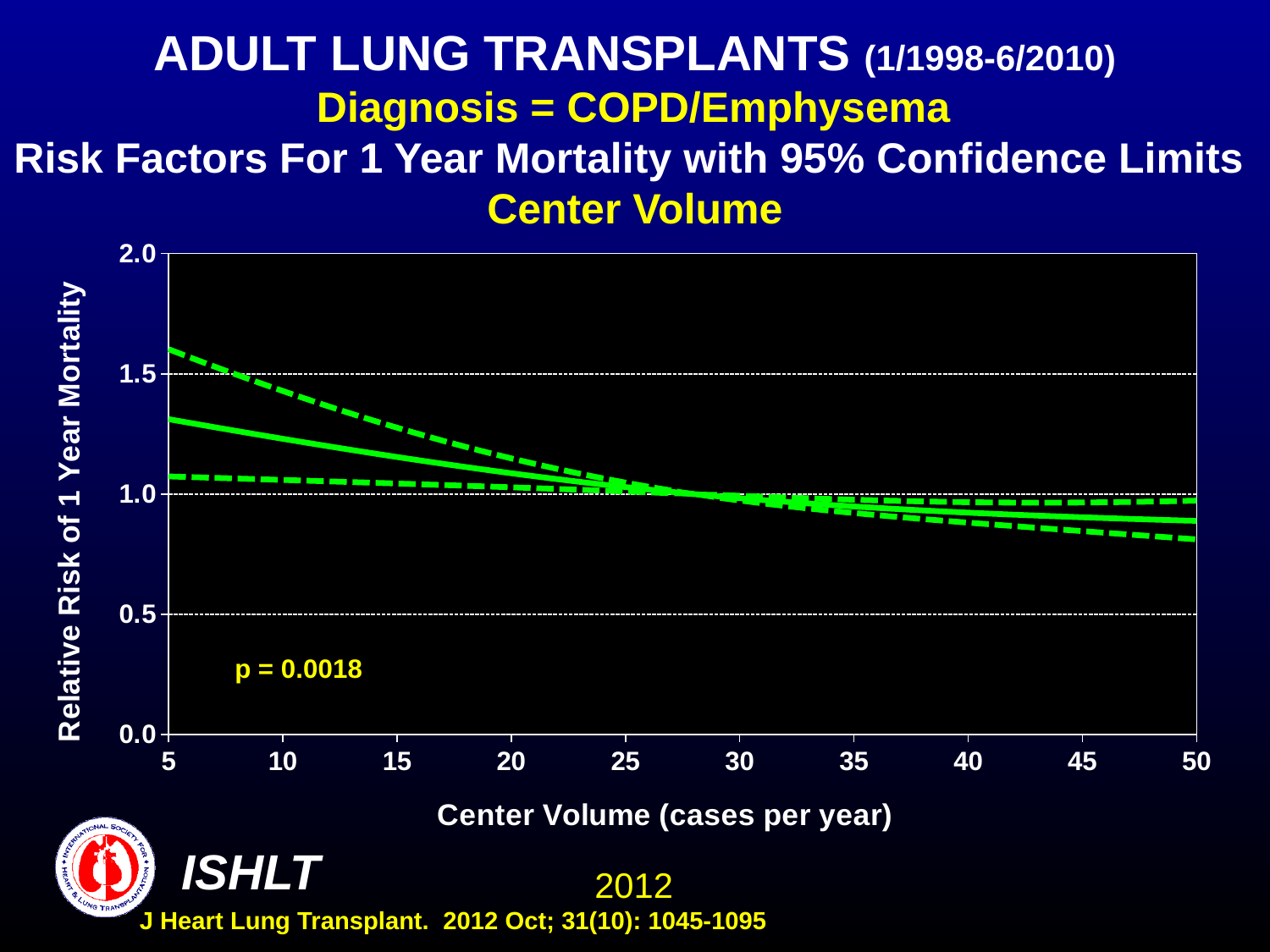
At a center volume of 5 cases per year, is the upper dashed confidence limit greater or less than 1.5? greater How many tick labels are shown on the x axis? 10 At a center volume of 50 cases per year, is the lower dashed confidence limit greater or less than 1.0? less Does the solid relative risk line rise or fall as center volume increases from 5 to 50 cases per year? fall What p-value is printed on the chart? p = 0.0018 How many lines are plotted on the chart? 3 At a center volume of 5 cases per year, is the lower dashed confidence limit greater or less than 1.5? less What kind of chart is shown on the slide? line chart What is the label of the x axis? Center Volume (cases per year)